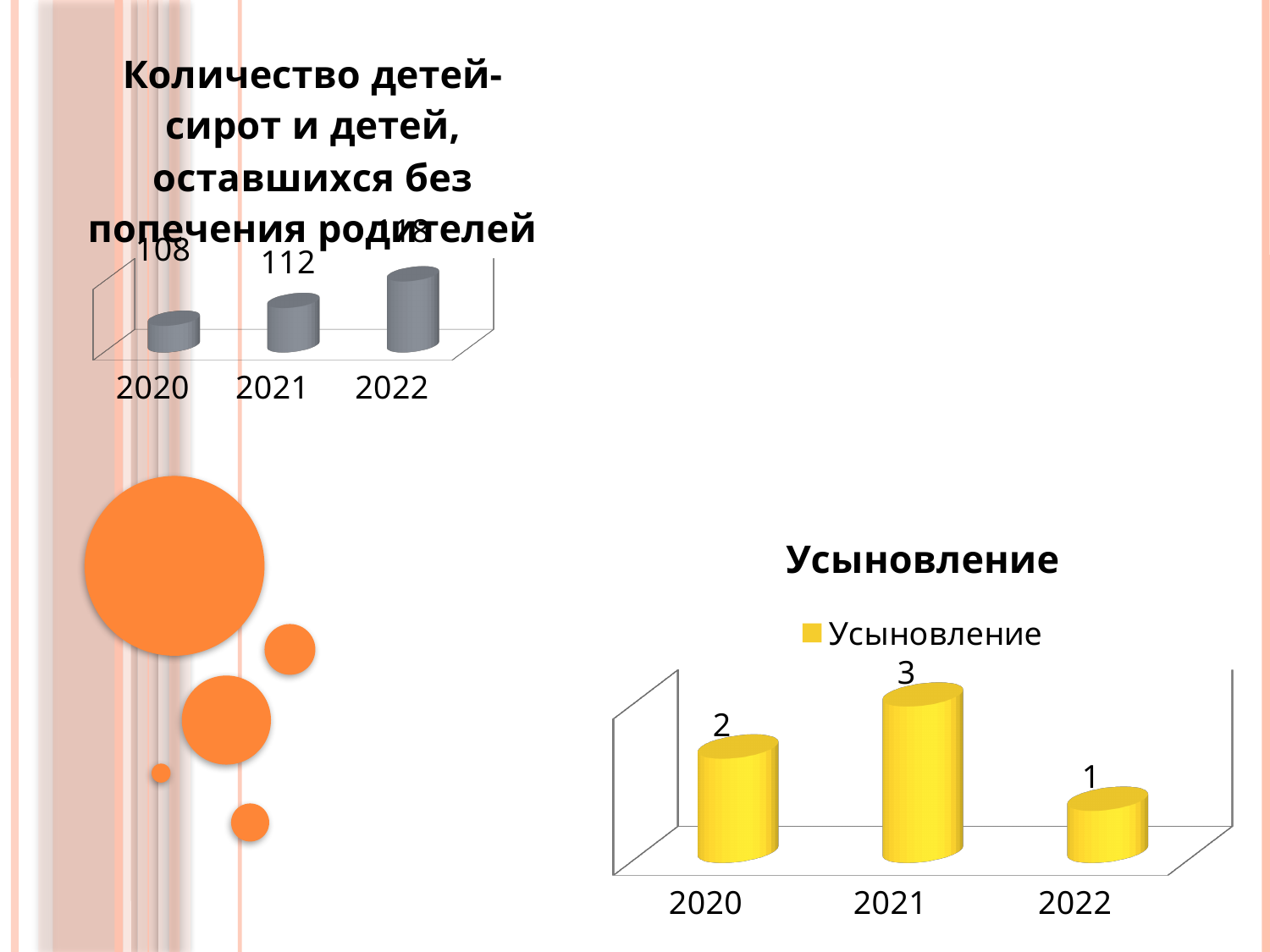
In the chart titled 'Усыновление', what is the value for 2021? 3 In the top-left chart about children without parental care, which is larger, the value for 2021 or the value for 2020? 2021 In the chart titled 'Усыновление', how many series does the legend list? 1 How many categories are shown on the x axis of the chart titled 'Усыновление'? 3 In the chart titled 'Усыновление', which year has the lowest value? 2022 In the top-left chart about children without parental care, what is the value for 2021? 112 In the chart titled 'Усыновление', what is the value for 2020? 2 In the chart titled 'Усыновление', what is the value for 2022? 1 In the chart titled 'Усыновление', which year has the highest value? 2021 In the chart titled 'Усыновление', what is the difference between the values for 2021 and 2020? 1 In the top-left chart about children without parental care, do the values rise or fall from 2020 to 2022? rise In the top-left chart about children without parental care, what is the value for 2020? 108